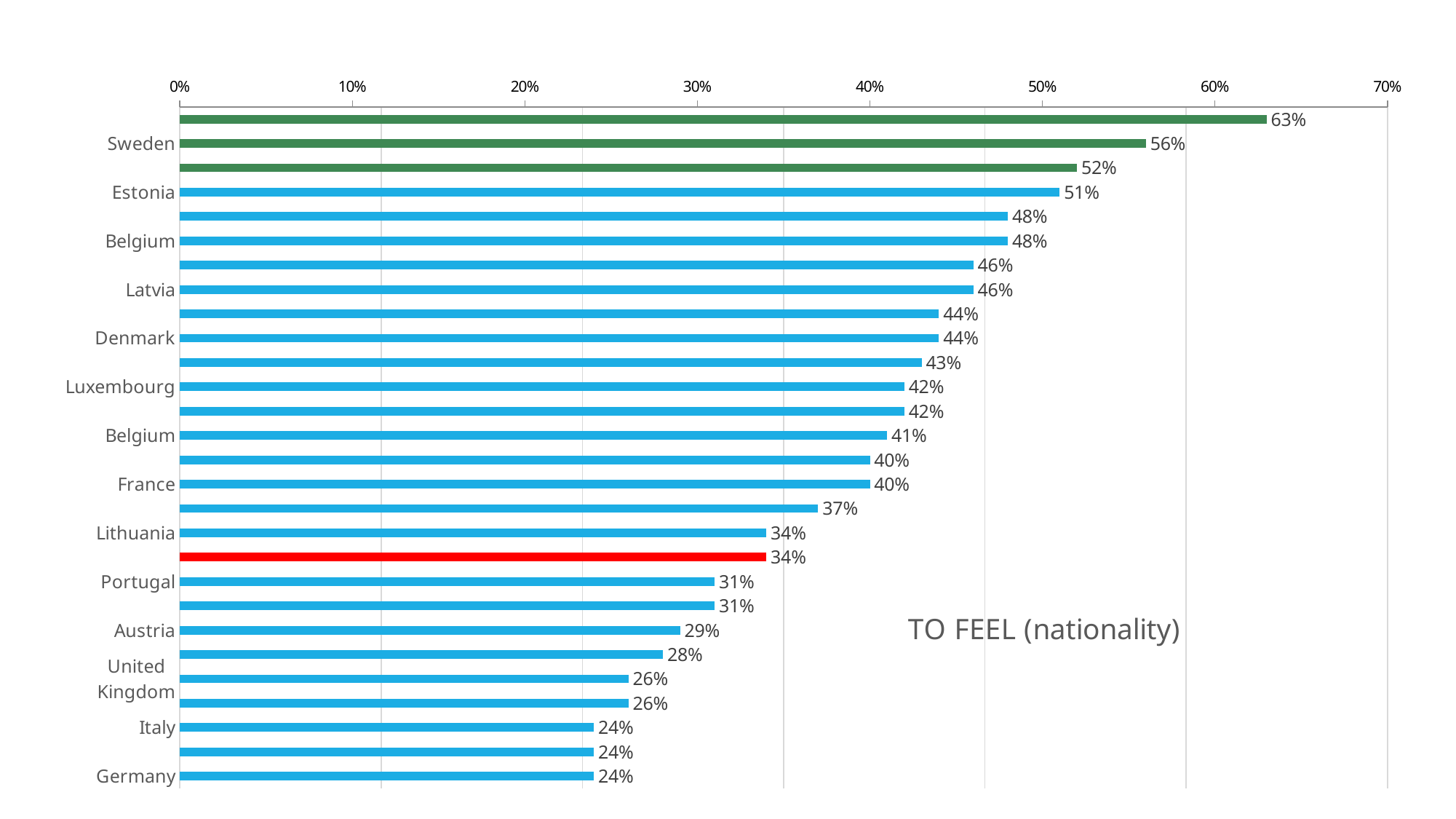
What is the value for France? 40% What is the value of the red bar? 34% Is the value for Austria greater or less than 30%? less What is the value for Luxembourg? 42% What is the value for Latvia? 46% What is the value for Germany? 24% What is the value for Sweden? 56% What is the value for Estonia? 51% Which has a larger value, Latvia or Denmark? Latvia What is the highest value shown on the chart? 63% What kind of chart is shown on the slide? Bar chart What is the difference between the values for Sweden and Estonia? 5 percentage points